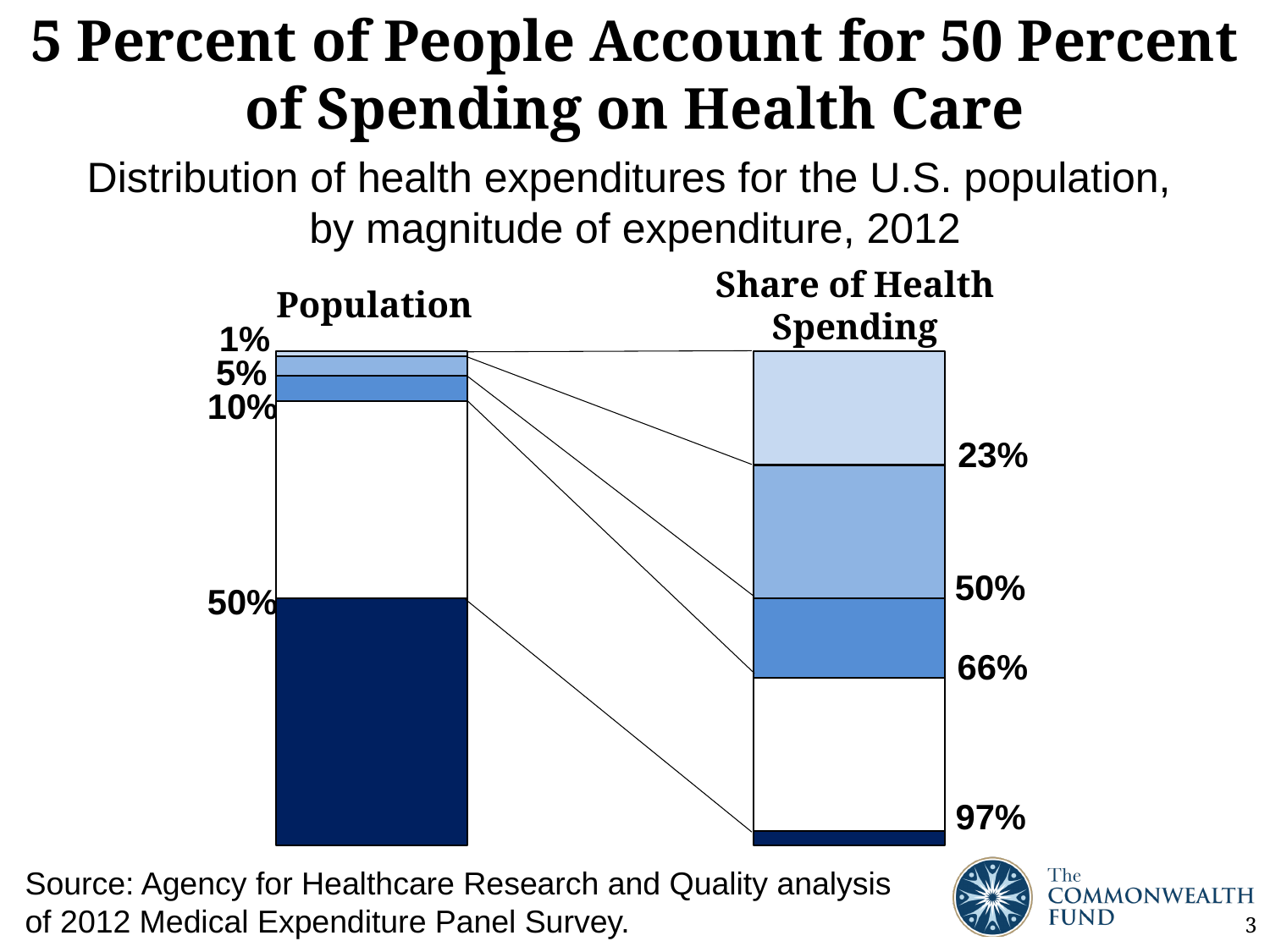
According to the chart, what share of health spending is accounted for by the top 50% of the population? 97% What is the highest percentage label shown on the Share of Health Spending bar? 97% How many bars does the chart show? 2 What is the title of the chart below the slide heading? Distribution of health expenditures for the U.S. population, by magnitude of expenditure, 2012 Which is larger: the share of health spending for the top 1% of the population or for the top 5%? Top 5% (50%) According to the chart, what share of health spending is accounted for by the top 10% of the population? 66% What is the difference between the 66% and 50% labels on the Share of Health Spending bar? 16 percentage points What is the lowest percentage label shown on the Population bar? 1% According to the chart, what share of health spending is accounted for by the top 5% of the population? 50% What are the labels of the two bars in the chart? Population; Share of Health Spending What kind of chart is shown on the slide? Bar chart According to the chart, what share of health spending is accounted for by the top 1% of the population? 23%